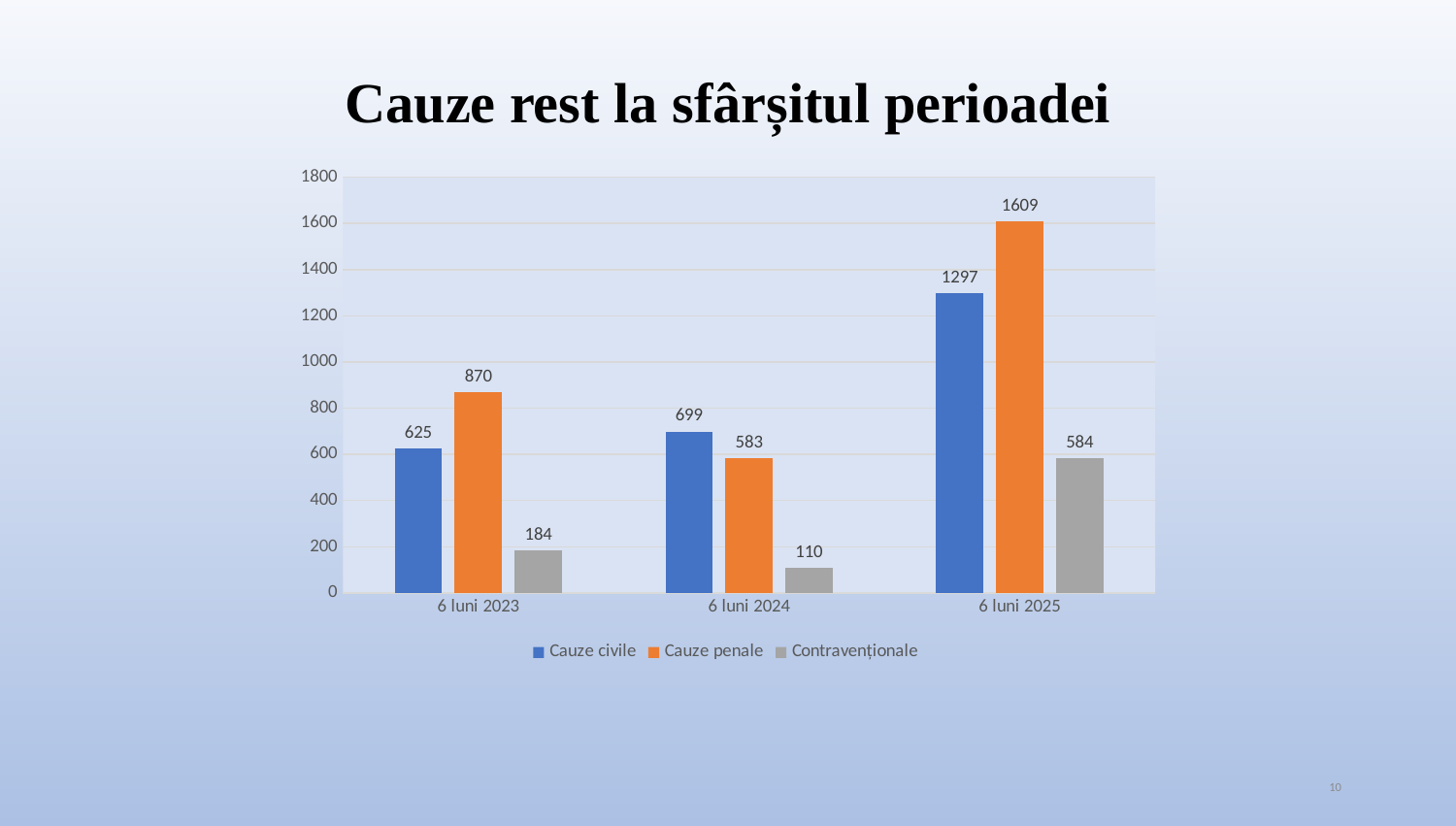
What is the value for Cauze civile in 6 luni 2024? 699 What is the value for Cauze penale in 6 luni 2025? 1609 Which period has the highest value for Cauze civile? 6 luni 2025 Which period has the lowest value for Contravenționale? 6 luni 2024 Which is larger in 6 luni 2024: Cauze civile or Cauze penale? Cauze civile Does the value for Cauze civile rise or fall from 6 luni 2023 to 6 luni 2025? Rise How many series does the legend list? 3 How many periods are shown on the x axis? 3 What kind of chart is shown on the slide? Bar chart What is the value for Contravenționale in 6 luni 2023? 184 What is the difference between Cauze penale and Cauze civile in 6 luni 2025? 312 What is the title of the chart? Cauze rest la sfârșitul perioadei